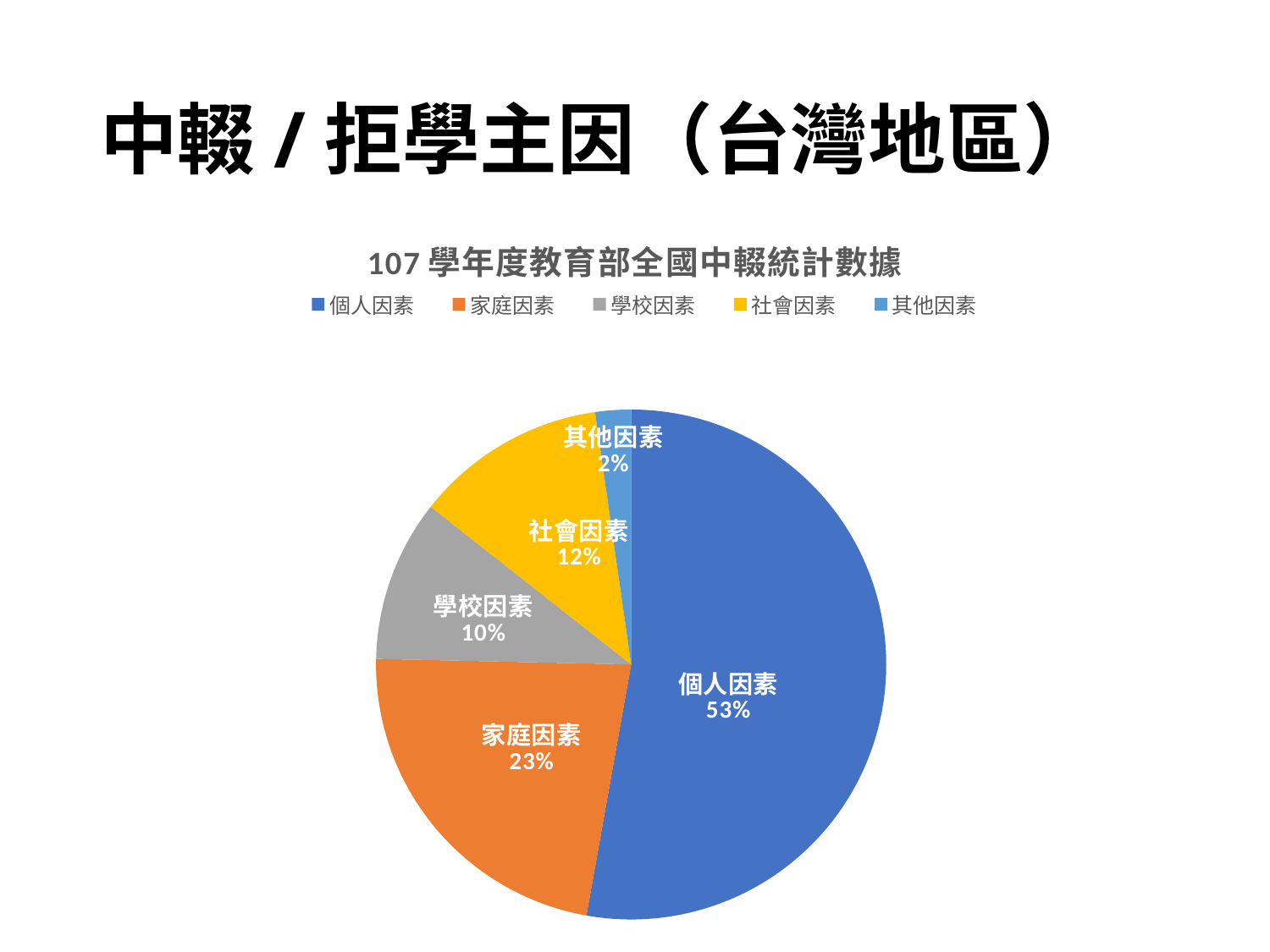
Which category has the smallest slice of the pie? 其他因素 What is the value shown for 家庭因素? 23% What is the value shown for 學校因素? 10% What share of the pie does 個人因素 account for? 53% What is the difference in percentage points between 個人因素 and 家庭因素? 30 What kind of chart is shown on the slide? Pie chart What colour is the slice for 家庭因素? Orange How many categories are shown in the pie chart? 5 Which category has the largest slice of the pie? 個人因素 What is the value shown for 社會因素? 12% What is the title of the chart? 107 學年度教育部全國中輟統計數據 Which is larger, 社會因素 or 學校因素? 社會因素